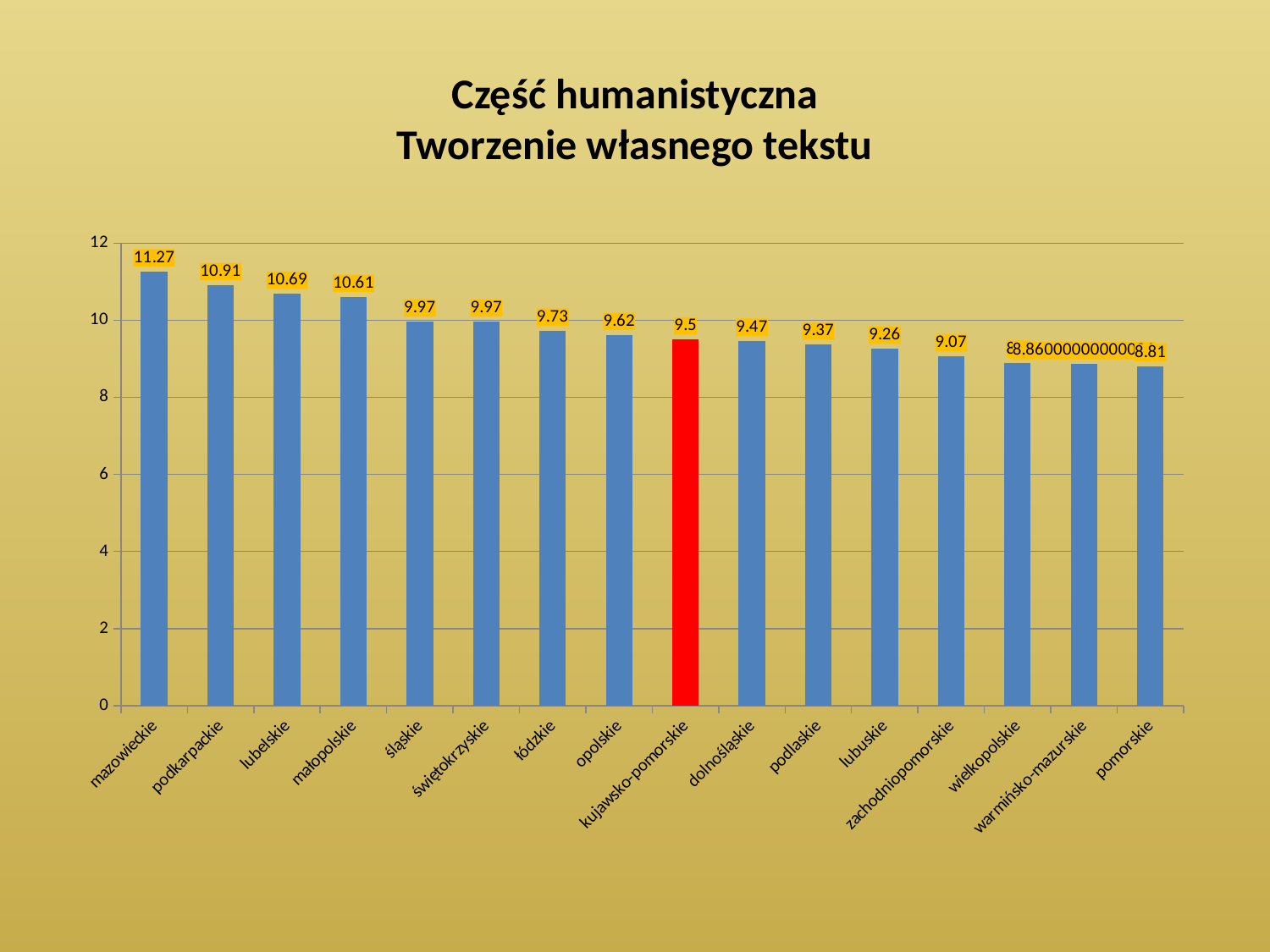
Which is larger, the value for łódzkie or the value for lubuskie? łódzkie What is the difference between the values for podkarpackie and lubelskie? 0.22 Which category's bar is coloured red? kujawsko-pomorskie What is the difference between the values for mazowieckie and pomorskie? 2.46 Which category has the lowest value? pomorskie How many categories are shown on the x axis? 16 Which category has the highest value? mazowieckie What is the value for zachodniopomorskie? 9.07 What kind of chart is shown on the slide? bar chart What is the value for mazowieckie? 11.27 What is the value for kujawsko-pomorskie? 9.5 Is the value for małopolskie greater or less than 10? greater